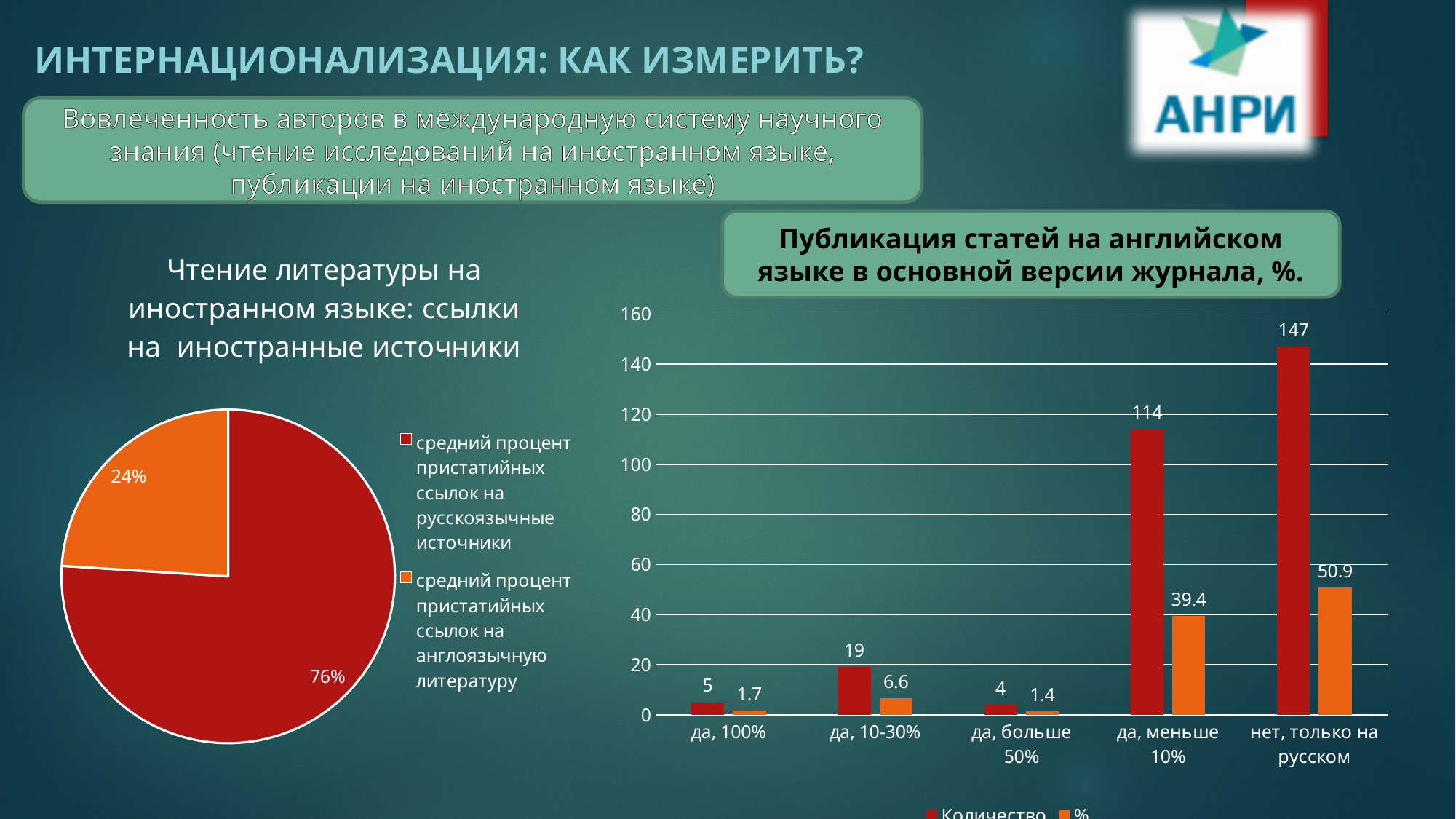
In the bar chart on the right, which category has the lowest Количество value? да, больше 50% In the bar chart on the right, what is the Количество value for 'да, 10-30%'? 19 In the bar chart on the right, what is the difference between the Количество values for 'нет, только на русском' and 'да, меньше 10%'? 33 In the bar chart on the right, which is larger: the Количество value for 'да, 100%' or for 'да, 10-30%'? да, 10-30% In the pie chart on the left, what share is shown for the average percentage of references to Russian-language sources (the red slice)? 76% In the pie chart on the left, what share is shown for the average percentage of references to English-language literature (the orange slice)? 24% In the bar chart on the right, what is the Количество value for the category 'нет, только на русском'? 147 In the bar chart on the right, what is the % value for the category 'да, меньше 10%'? 39.4 What type of chart is the chart on the left of the slide? pie chart In the bar chart on the right, which category has the highest % value? нет, только на русском How many categories are shown on the x axis of the bar chart on the right? 5 How many series does the legend of the bar chart on the right list? 2